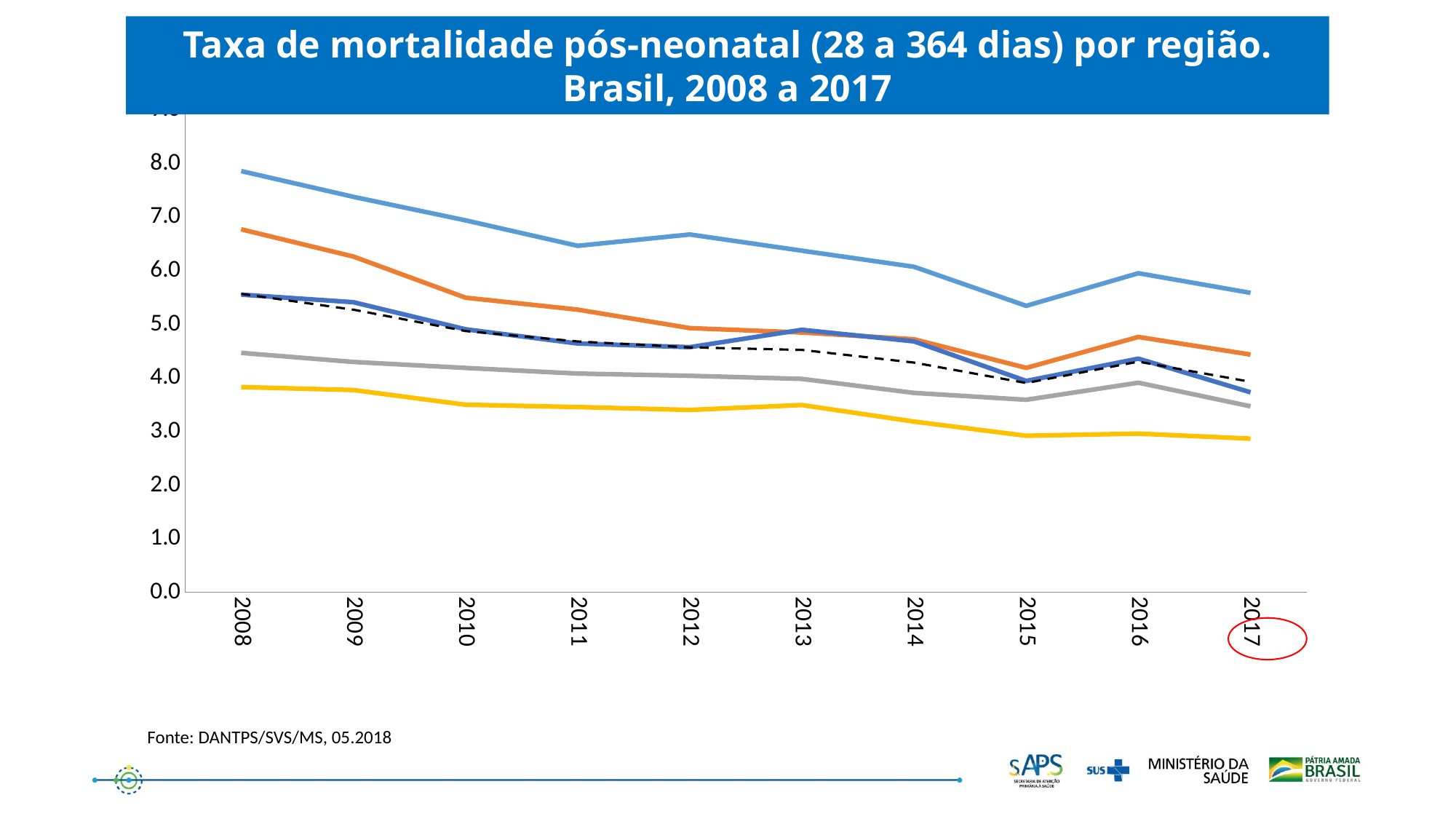
Which line is the highest across all years on the chart? the light blue line What source is cited below the chart? DANTPS/SVS/MS, 05.2018 Which line is the lowest across all years on the chart? the yellow line Is the value of the light blue line in 2008 greater or less than 7.0? greater In 2017, which is larger: the value of the light blue line or the value of the yellow line? the light blue line How many lines are plotted on the chart? 6 Does the light blue line rise or fall overall from 2008 to 2017? fall What is the title of the chart? Taxa de mortalidade pós-neonatal (28 a 364 dias) por região. Brasil, 2008 a 2017 Is the value of the yellow line in 2017 greater or less than 3.0? less What kind of chart is shown on the slide? line chart Is the value of the orange line in 2008 greater or less than 6.0? greater How many years are shown on the x axis of the chart? 10